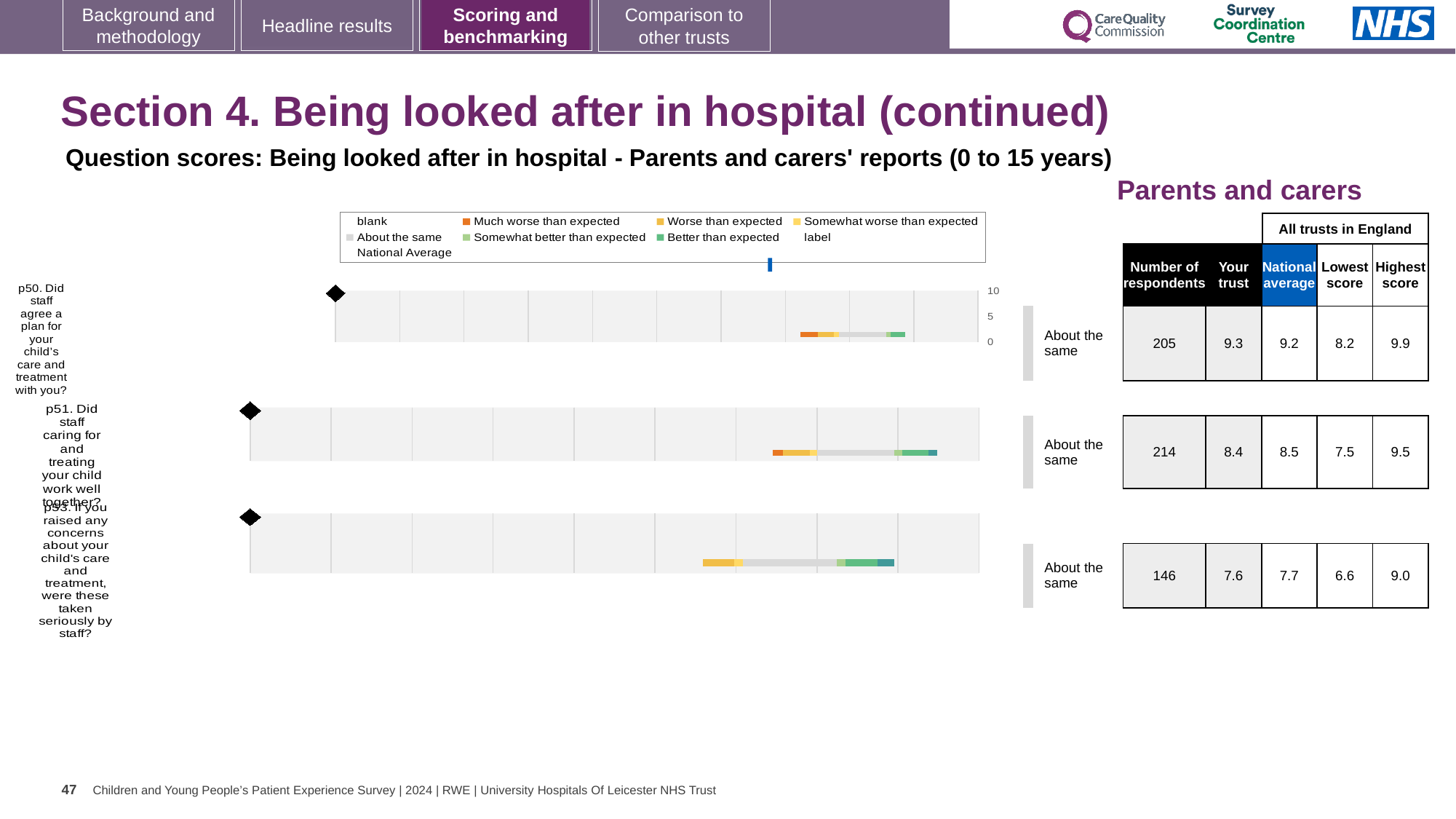
Is the 'Your trust' score for p50 larger or smaller than its national average? larger How many respondents answered p53 (If you raised any concerns about your child's care and treatment, were these taken seriously by staff)? 146 Which question has the highest 'Your trust' score? p50 What is the 'Your trust' score for p50 (Did staff agree a plan for your child's care and treatment with you)? 9.3 What kind of chart is used for each question on this slide? bar chart What is the national average score for p51 (Did staff caring for and treating your child work well together)? 8.5 What benchmark category is shown for p53? About the same Which legend entry is shown in orange? Much worse than expected Which question has the lowest number of respondents? p53 How many question charts are shown on the slide? 3 What is the difference between the highest score and the lowest score for p50? 1.7 What is the highest tick value shown on the axis of the p50 chart? 10